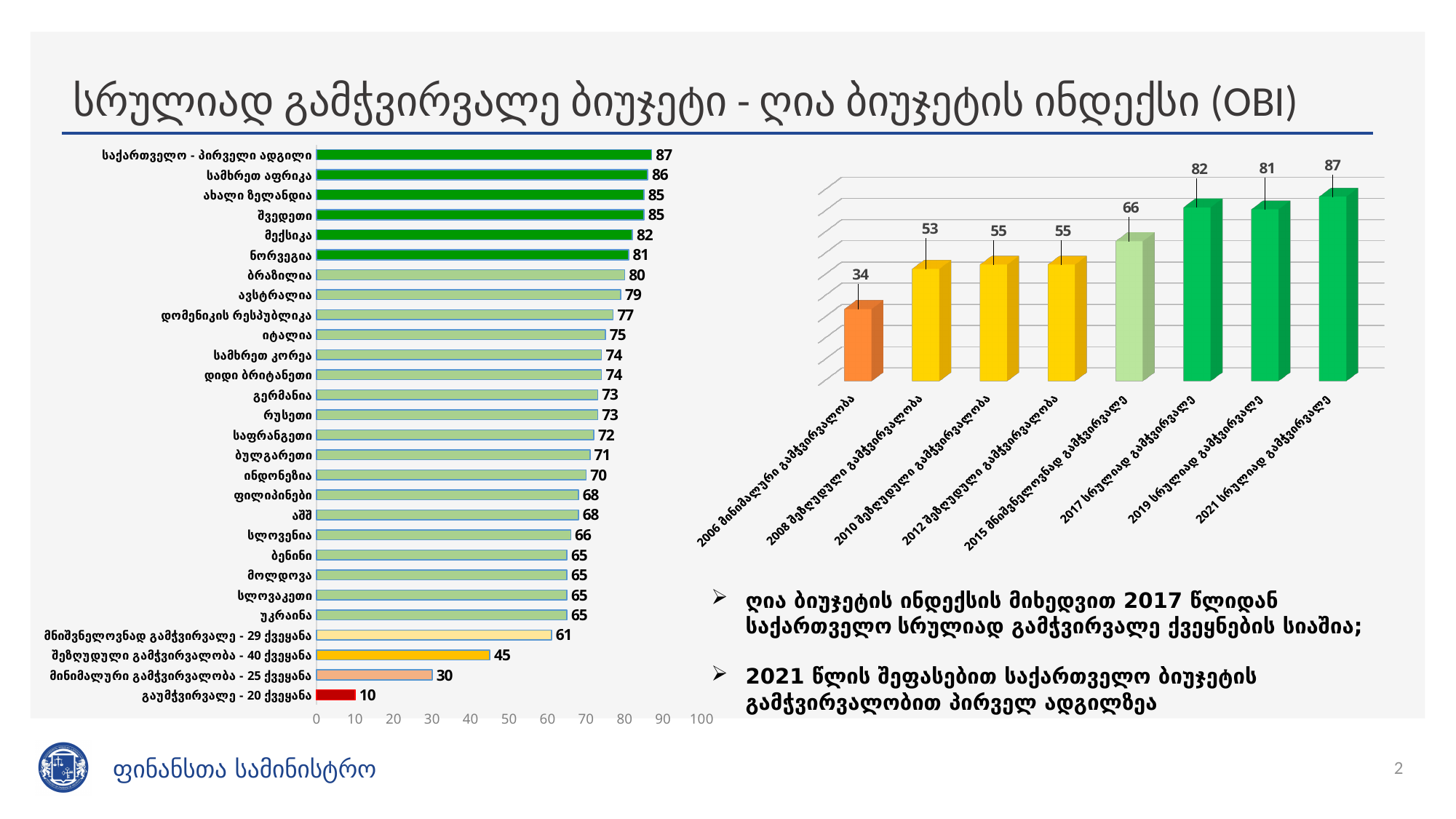
In the chart on the right, what is the value for 2021? 87 In the chart on the right, what is the difference between the 2021 value and the 2015 value? 21 In the chart on the left, which category has the lowest value? გაუმჭვირვალე - 20 ქვეყანა In the chart on the left, which category has the highest value? საქართველო - პირველი ადგილი What kind of chart is shown on the left of the slide? bar chart In the chart on the right, do the values generally rise or fall from 2006 to 2021? rise In the chart on the right, which year has the lowest value? 2006 In the chart on the left, what is the value for სამხრეთ აფრიკა? 86 In the chart on the left, what is the value for გერმანია? 73 In the chart on the right, how many bars are plotted? 8 In the chart on the right, what is the value for 2006? 34 In the chart on the left, which is larger, the value for ბრაზილია or the value for იტალია? ბრაზილია